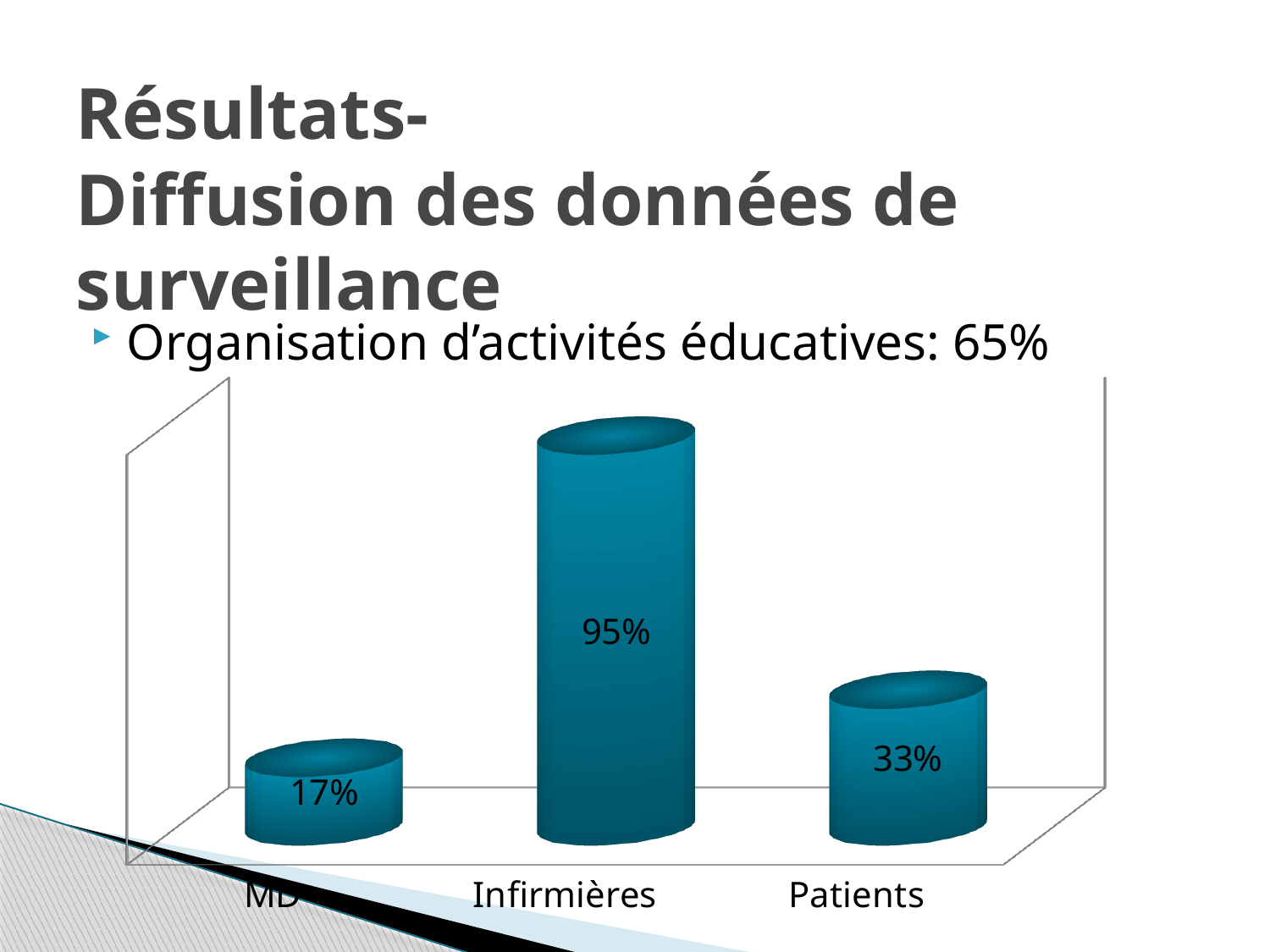
What is the value for Infirmières? 95% Which category has the lowest value? MD What is the value for MD? 17% What kind of chart is shown on the slide? Bar chart Which is larger, the value for Patients or the value for MD? Patients What is the value for Patients? 33% What is the difference between the values for Infirmières and Patients? 62% How many categories are shown in the chart? 3 Which is larger, the value for Infirmières or the value for Patients? Infirmières What is the difference between the values for Patients and MD? 16% What colour are the bars in the chart? Teal blue Which category has the highest value? Infirmières